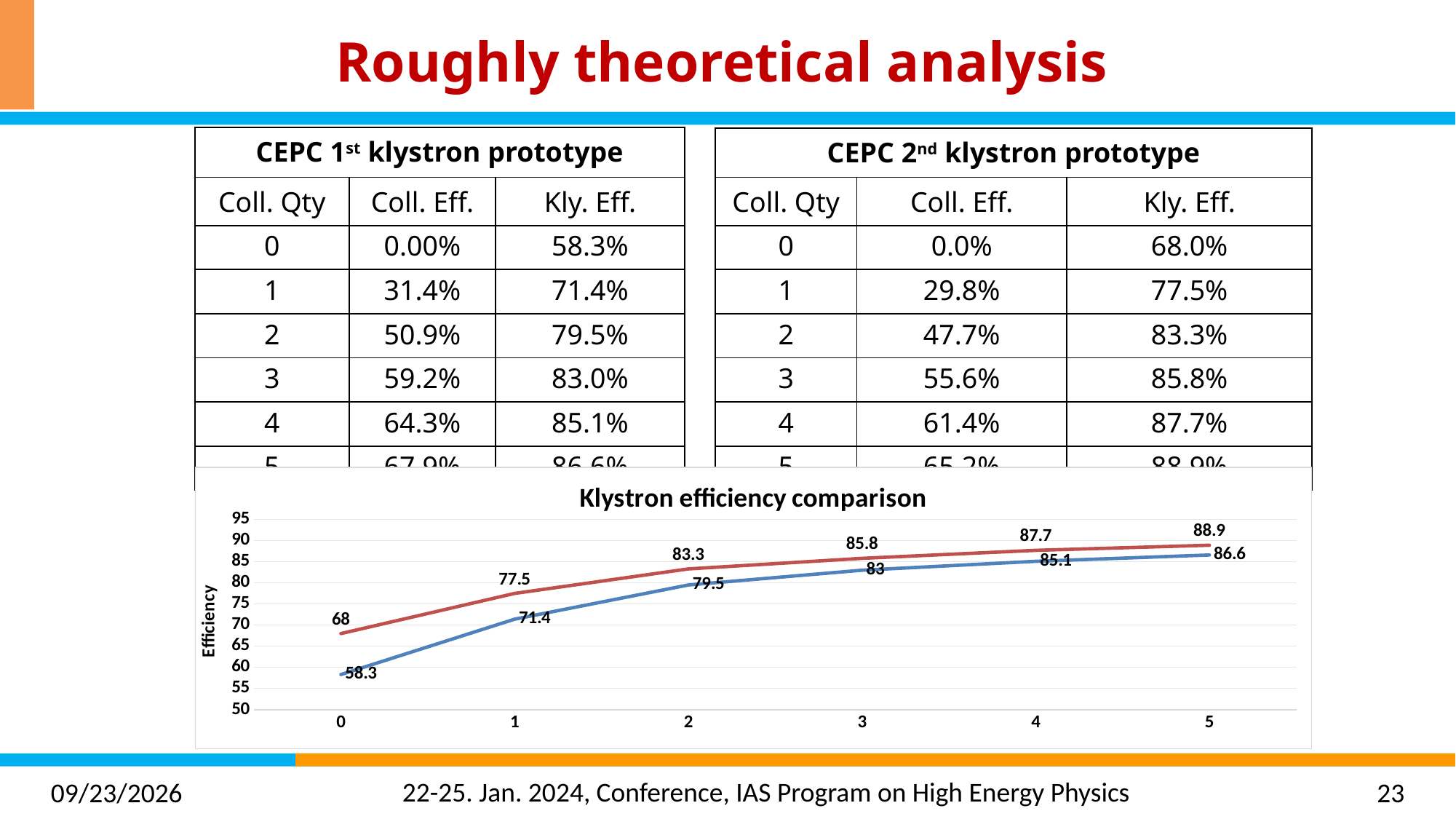
In the "Klystron efficiency comparison" chart, what is the difference between the red and blue lines at x = 5? 2.3 In the "Klystron efficiency comparison" chart, what is the difference between the red and blue lines at x = 0? 9.7 In the "Klystron efficiency comparison" chart, how many x-axis points are plotted on each line? 6 What type of chart is the "Klystron efficiency comparison" chart? line chart In the "Klystron efficiency comparison" chart, do the values rise or fall as x increases from 0 to 5? rise In the "Klystron efficiency comparison" chart, what is the lowest value on the blue line? 58.3 In the "Klystron efficiency comparison" chart, what is the highest value on the red line? 88.9 In the "Klystron efficiency comparison" chart, what is the value of the blue line at x = 5? 86.6 In the "Klystron efficiency comparison" chart, which line has the higher value at x = 2, red or blue? red In the "Klystron efficiency comparison" chart, what is the value of the red line at x = 3? 85.8 In the "Klystron efficiency comparison" chart, what is the value of the red line at x = 0? 68 In the "Klystron efficiency comparison" chart, what is the value of the blue line at x = 0? 58.3